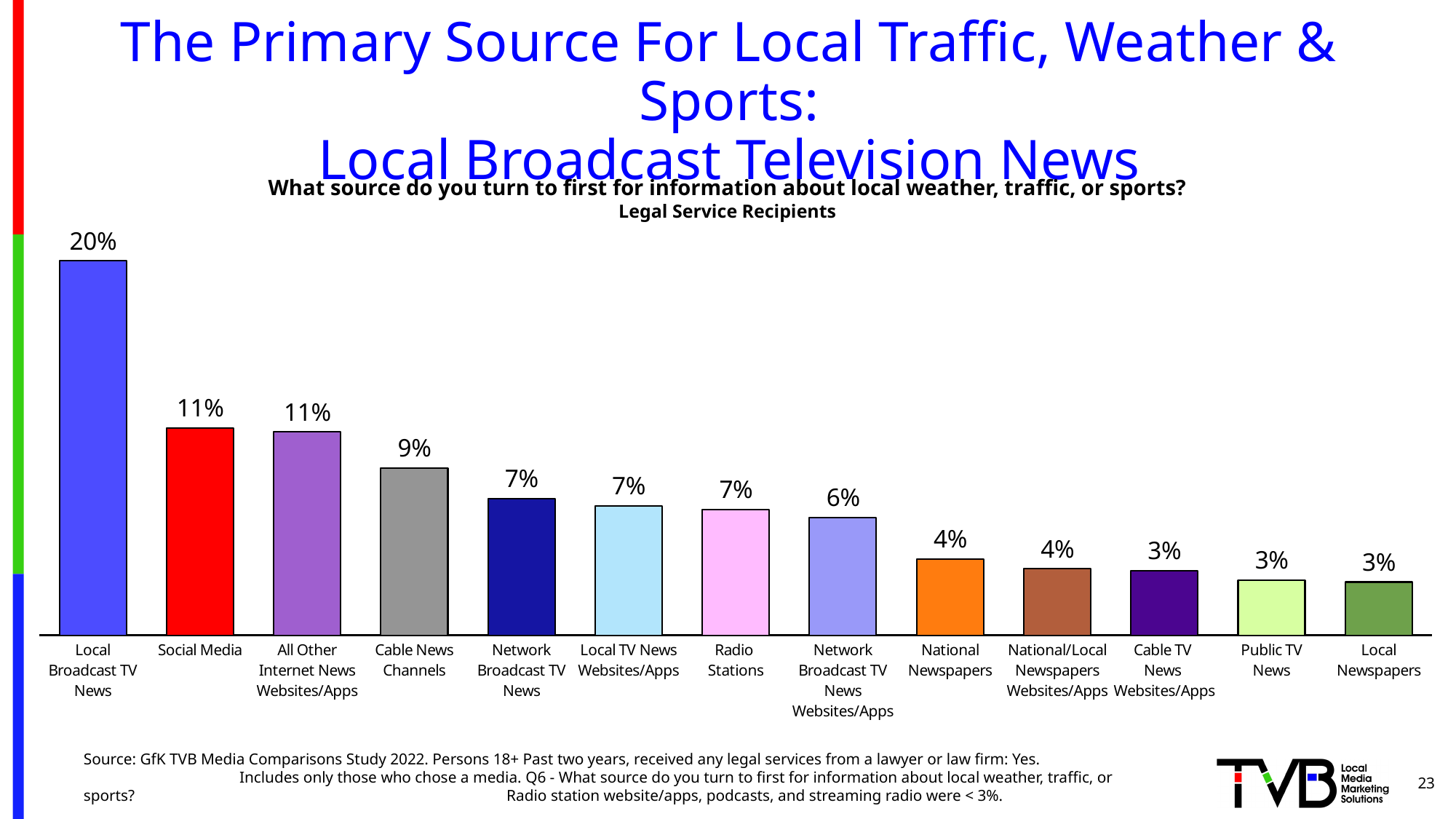
What is the difference between Cable News Channels and Radio Stations? 2% What is the value for Network Broadcast TV News Websites/Apps? 6% Which is larger, Social Media or Network Broadcast TV News? Social Media What kind of chart is shown on the slide? Bar chart What is the value for Local Broadcast TV News? 20% How many categories are shown in the chart? 13 Which category has the highest value? Local Broadcast TV News Do the values rise or fall from left to right along the x axis? Fall What is the difference between Local Broadcast TV News and Social Media? 9% What is the value for National Newspapers? 4% What group of respondents does the chart subtitle say the data is for? Legal Service Recipients What is the value for Cable News Channels? 9%